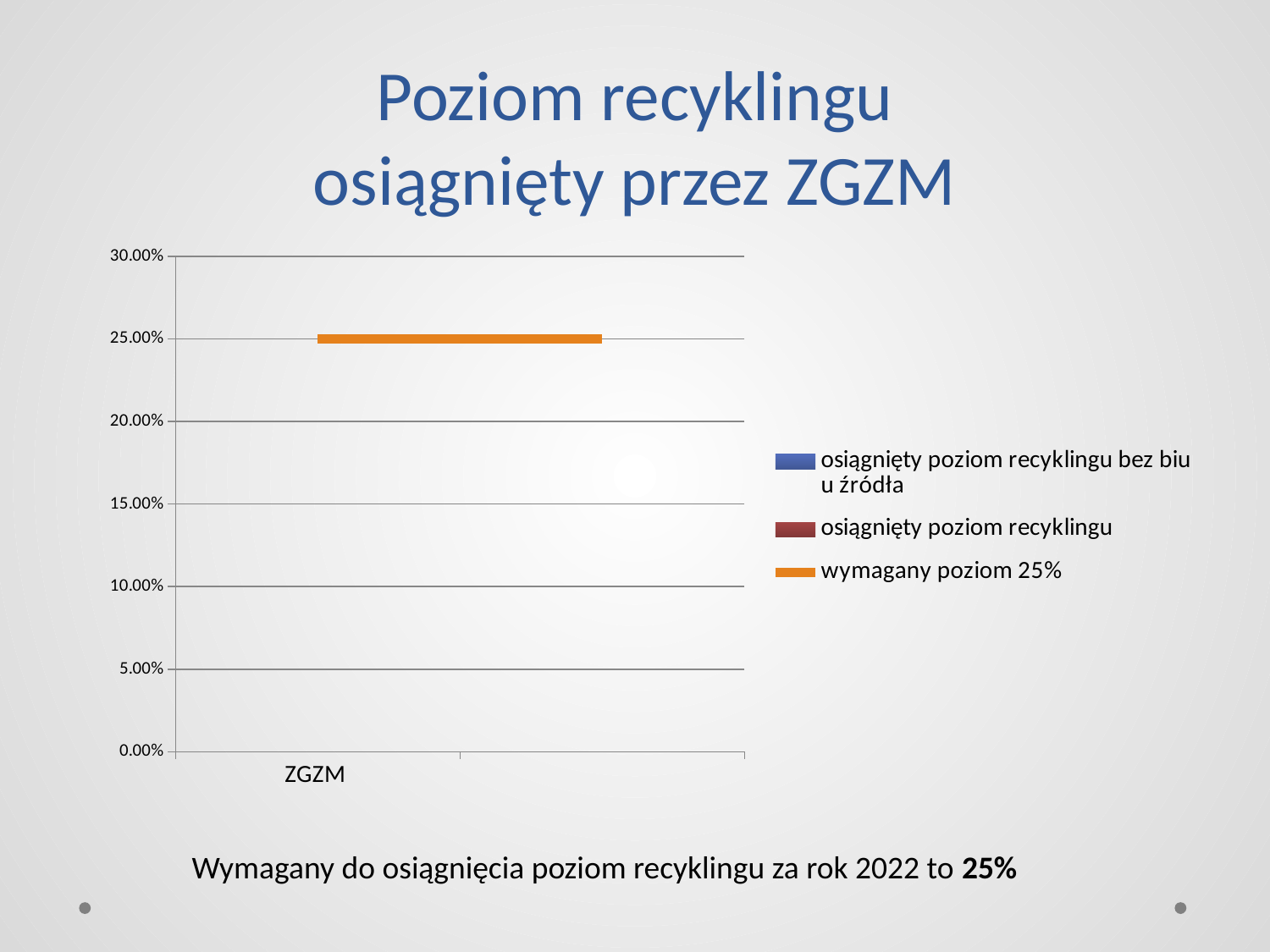
Is the value of the 'wymagany poziom 25%' series for ZGZM greater or less than 20.00%? greater What colour is used for the 'wymagany poziom 25%' series in the chart? orange How many series does the chart legend list? 3 How many categories are shown on the x axis of the chart? 1 What is the category label shown on the x axis of the chart? ZGZM What is the title of the chart on the slide? Poziom recyklingu osiągnięty przez ZGZM What is the lowest value shown on the y axis of the chart? 0.00% What value does the 'wymagany poziom 25%' series show for ZGZM? 25.00% Is the value of the 'wymagany poziom 25%' series for ZGZM greater or less than 30.00%? less What is the highest value shown on the y axis of the chart? 30.00%